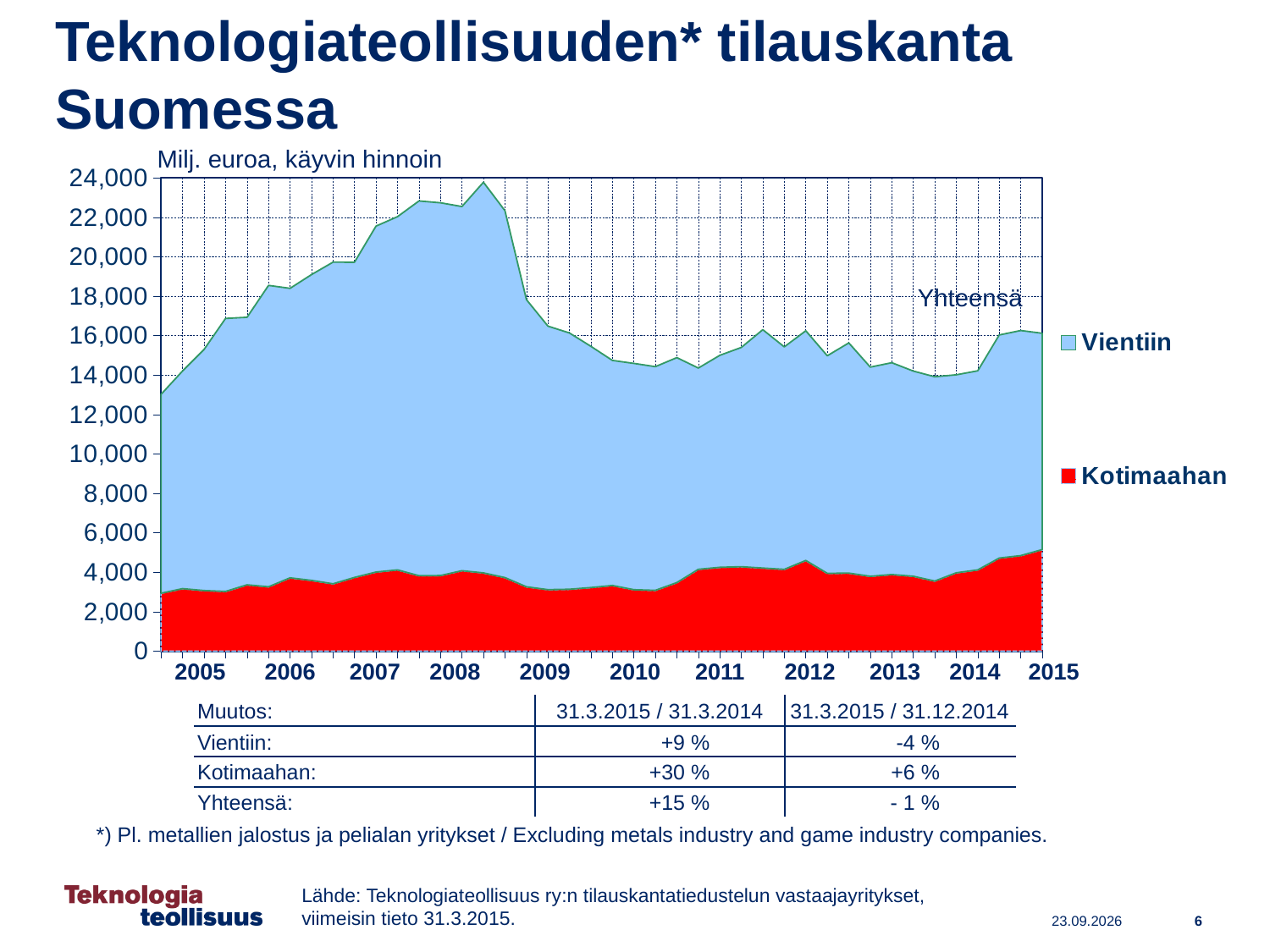
How many series does the chart legend list? 2 How many year labels are shown along the x axis of the chart? 11 In which year does the total (Yhteensä) order book reach its highest point? 2008 Which two series are listed in the chart legend? Vientiin and Kotimaahan Is the total (Yhteensä) value at its 2008 peak greater or less than 22,000? greater What unit label is shown above the chart's y axis? Milj. euroa, käyvin hinnoin Is the total (Yhteensä) value at the start of 2005 greater or less than 14,000? less Does the total (Yhteensä) order book rise or fall between 2008 and 2009? fall Which is larger, the total (Yhteensä) value in 2008 or in 2012? 2008 Is the Kotimaahan value at the end of the series in 2015 greater or less than 4,000? greater What kind of chart is shown on the slide? Stacked area chart